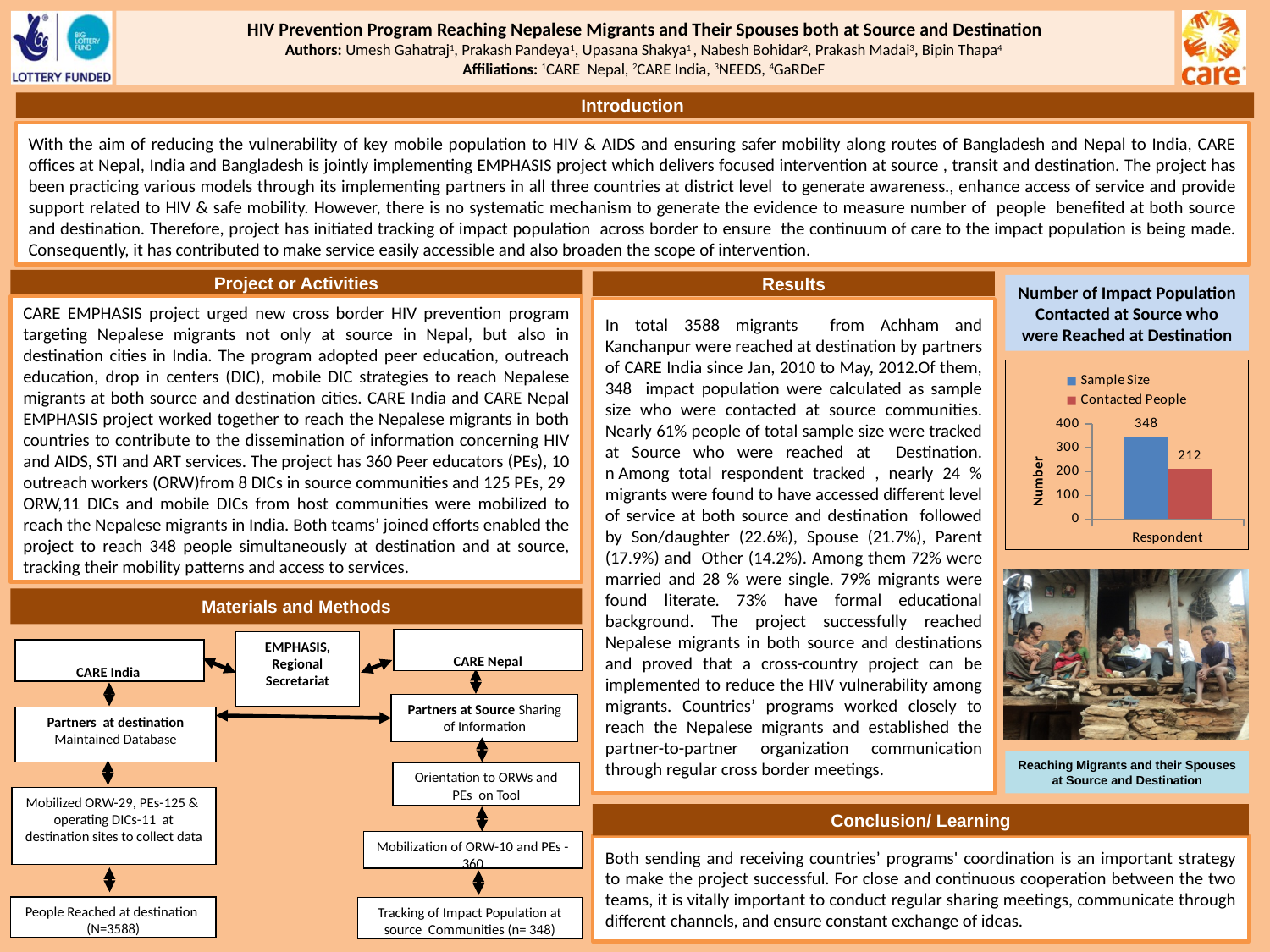
How many categories are shown on the x axis of the chart? 1 What kind of chart is shown on the slide? bar chart What is the label of the y axis of the chart? Number Which series has the higher value, Sample Size or Contacted People? Sample Size What is the category label on the x axis of the chart? Respondent Is the value for Sample Size greater or less than 300? greater How many series does the chart legend list? 2 What is the value for Sample Size in the chart? 348 Which series has the lowest value in the chart? Contacted People Is the value for Contacted People greater or less than 300? less What is the value for Contacted People in the chart? 212 What is the difference between the Sample Size and Contacted People values? 136